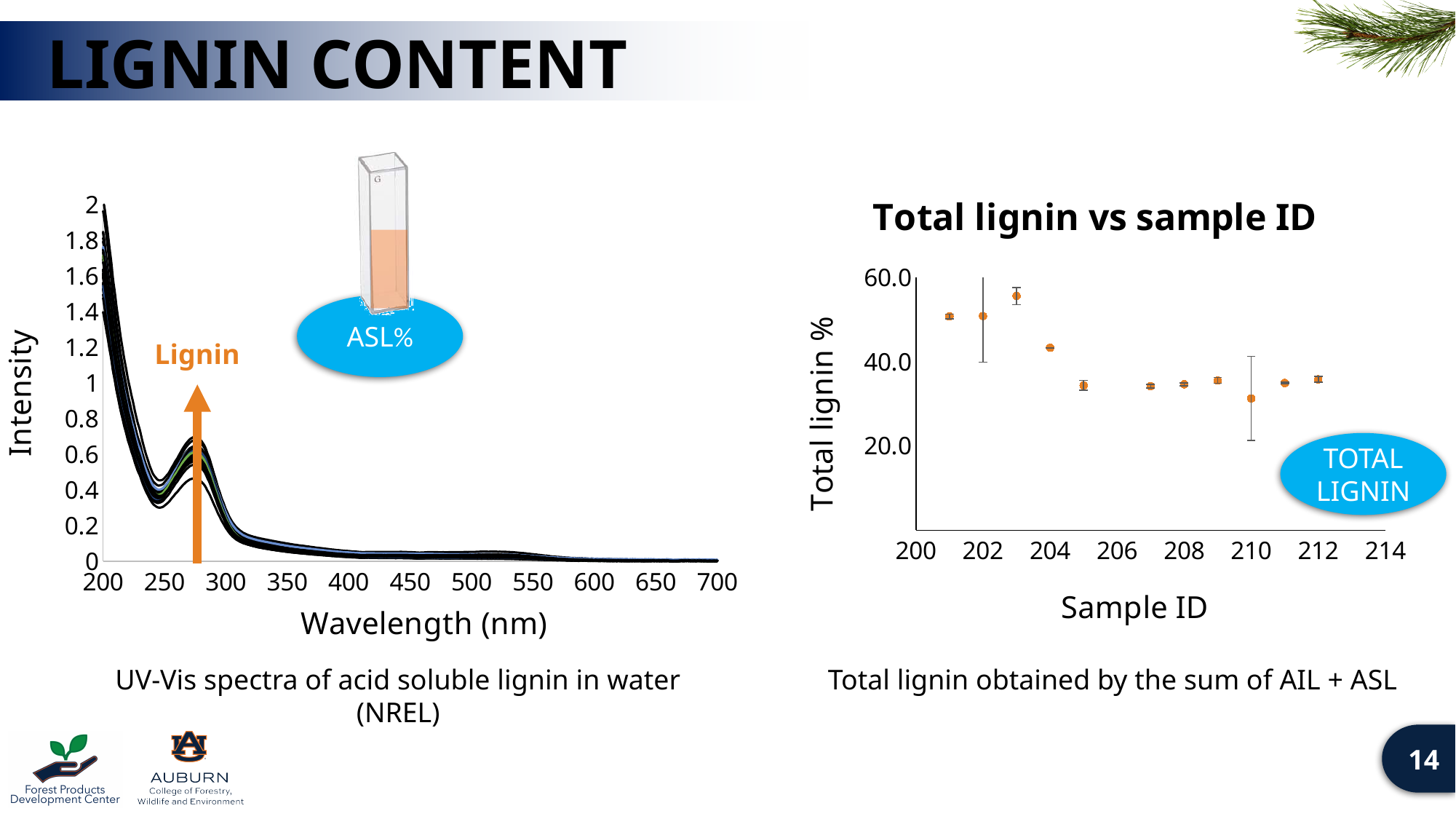
What is the x-axis label of the chart on the left of the slide? Wavelength (nm) What kind of chart is the UV-Vis spectra chart on the left of the slide? line chart In the 'Total lignin vs sample ID' chart, is the value for sample 210 greater or less than 40.0? less In the 'Total lignin vs sample ID' chart, which sample ID has the highest total lignin %? 203 In the 'Total lignin vs sample ID' chart, is the value for sample 203 greater or less than 40.0? greater In the 'Total lignin vs sample ID' chart, is the value for sample 205 greater or less than 40.0? less In the 'Total lignin vs sample ID' chart, which has a larger total lignin %, sample 201 or sample 207? 201 In the 'Total lignin vs sample ID' chart, do the total lignin values generally rise or fall as the sample ID increases? fall What kind of chart is the 'Total lignin vs sample ID' chart? scatter plot What is the title of the chart on the right of the slide? Total lignin vs sample ID